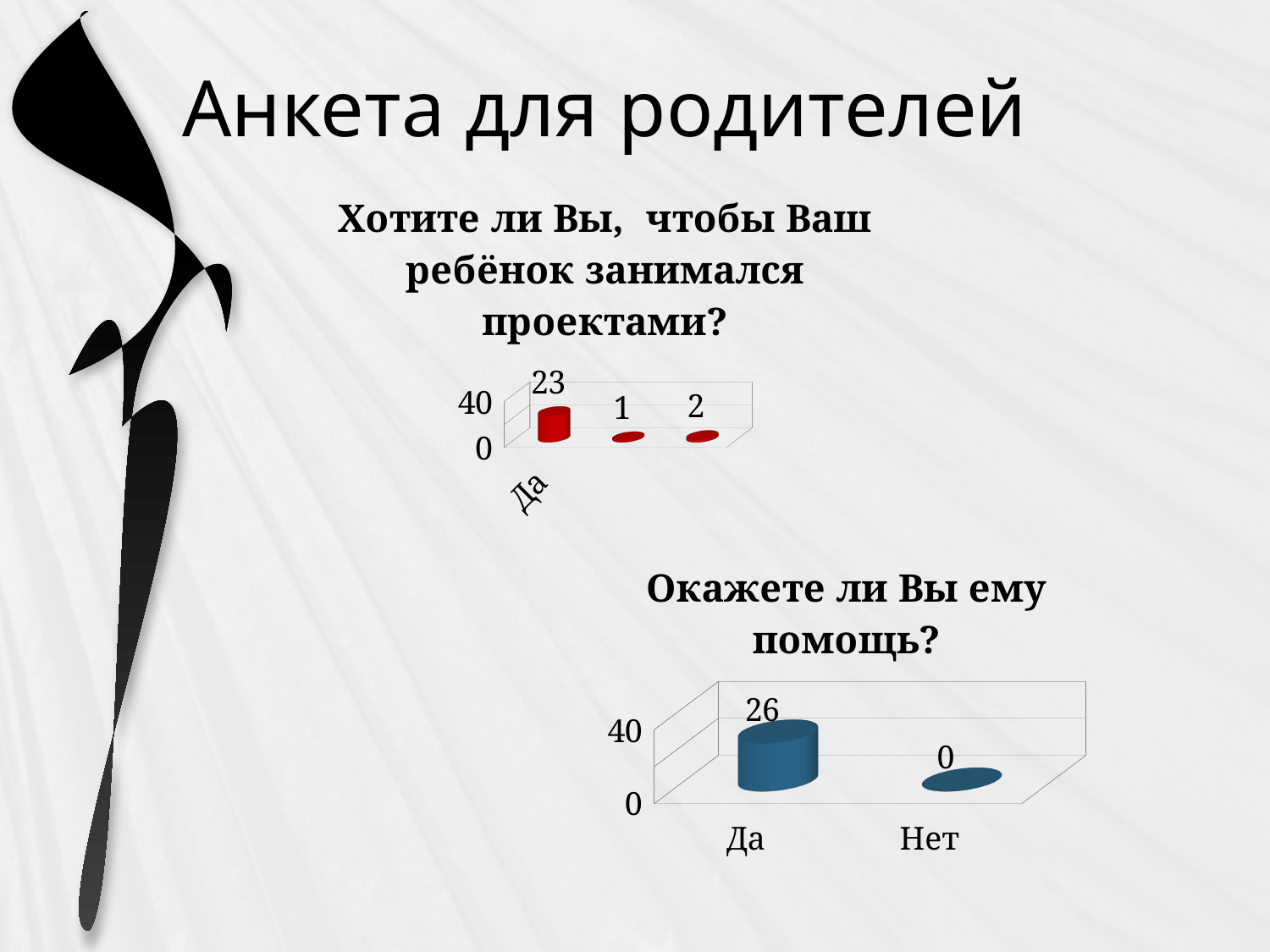
What colour are the bars in the chart titled "Хотите ли Вы, чтобы Ваш ребёнок занимался проектами?"? red In the chart titled "Окажете ли Вы ему помощь?", how many categories are shown? 2 In the chart titled "Окажете ли Вы ему помощь?", is the value for Да greater or less than 40? less In the chart titled "Окажете ли Вы ему помощь?", which category has the highest value? Да In the chart titled "Хотите ли Вы, чтобы Ваш ребёнок занимался проектами?", how many bars are shown? 3 In the chart titled "Окажете ли Вы ему помощь?", which category has the lowest value? Нет In the chart titled "Хотите ли Вы, чтобы Ваш ребёнок занимался проектами?", what is the value for Да? 23 In the chart titled "Хотите ли Вы, чтобы Ваш ребёнок занимался проектами?", which category has the highest value? Да What kind of chart is the one titled "Окажете ли Вы ему помощь?"? bar chart In the chart titled "Окажете ли Вы ему помощь?", what is the value for Да? 26 In the chart titled "Окажете ли Вы ему помощь?", what is the difference between the values for Да and Нет? 26 In the chart titled "Окажете ли Вы ему помощь?", what is the value for Нет? 0